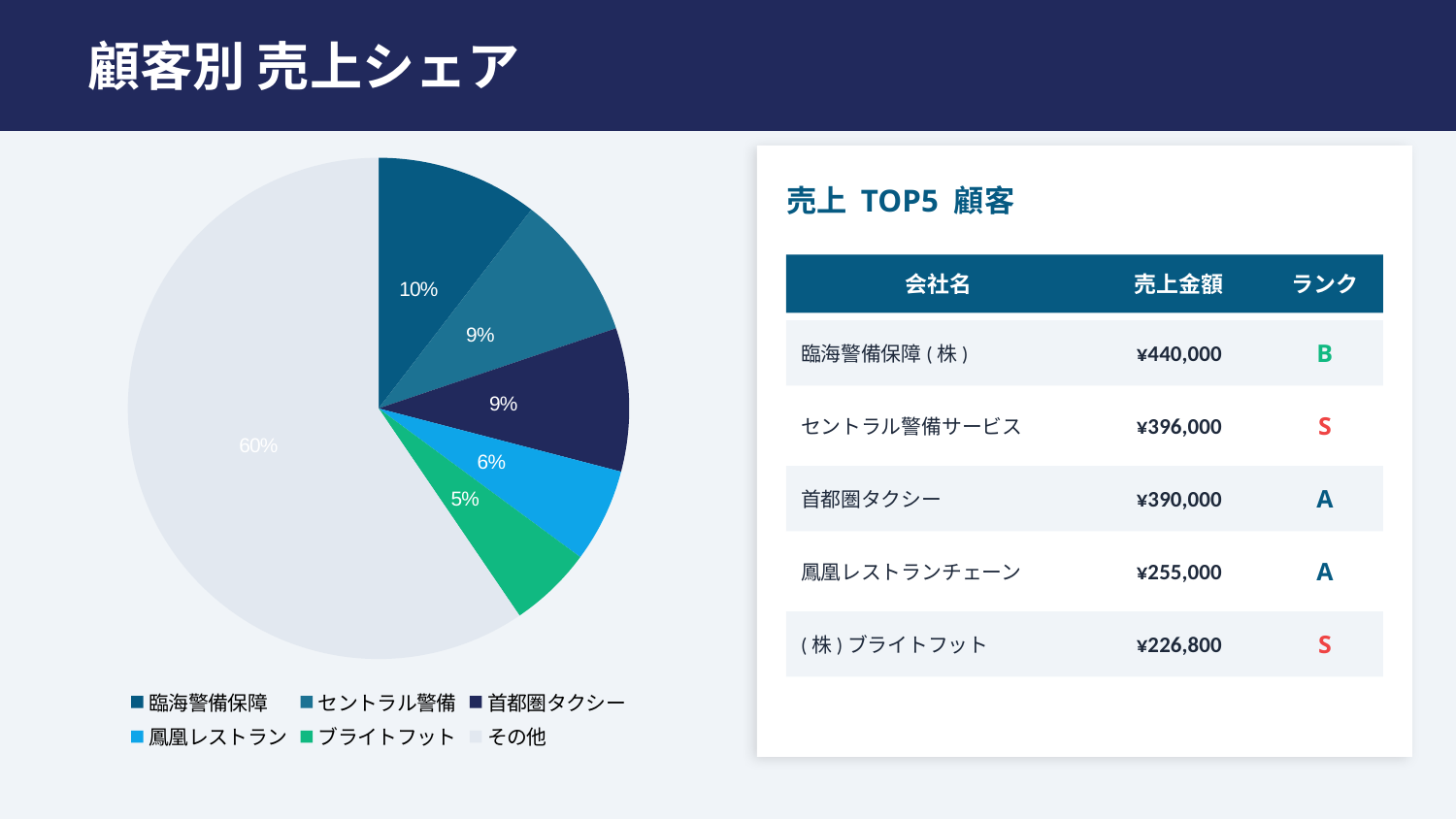
What kind of chart is shown on the slide? Pie chart What is the difference in percentage points between the shares of 臨海警備保障 and ブライトフット? 5 percentage points What share of the pie does 鳳凰レストラン hold? 6% How many entries does the pie chart's legend list? 6 What share of the pie does その他 hold? 60% Which has the larger share, 臨海警備保障 or 鳳凰レストラン? 臨海警備保障 How many slices does the pie chart have? 6 What share of the pie does セントラル警備 hold? 9% What share of the pie does ブライトフット hold? 5% Which slice of the pie is the largest? その他 Which slice of the pie is the smallest? ブライトフット